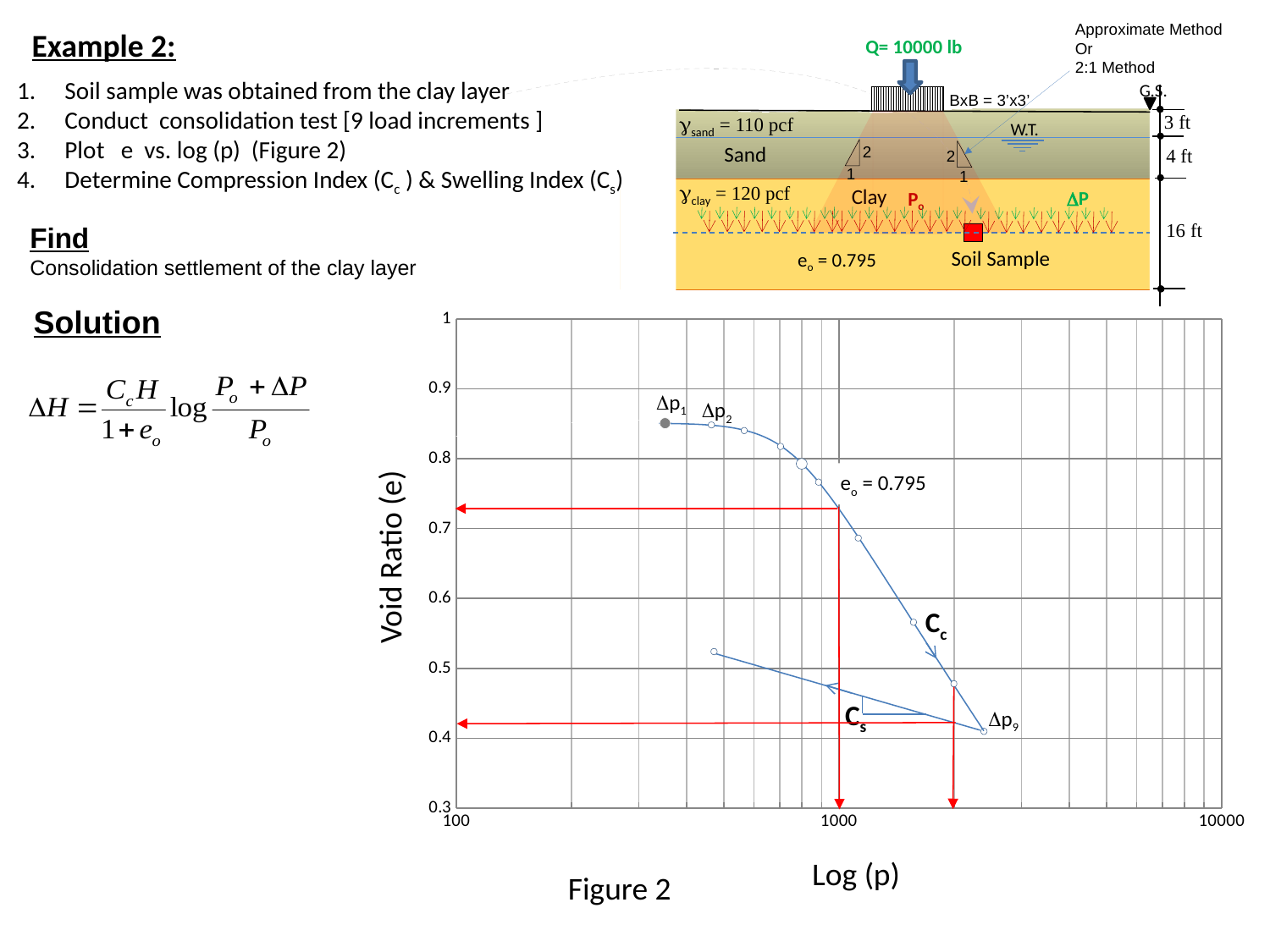
What is the label of the y-axis in Figure 2? Void Ratio (e) In Figure 2, what value of e_o is annotated on the chart? 0.795 What kind of chart is Figure 2? line chart What is the highest tick value shown on the y-axis of Figure 2? 1 What is the lowest tick value shown on the x-axis of Figure 2? 100 What is the label of the x-axis in Figure 2? Log (p) In Figure 2, is the void ratio at point Δp1 greater or less than 0.8? greater In Figure 2, is the void ratio at point Δp9 greater or less than 0.5? less In Figure 2, which point has the higher void ratio, Δp1 or Δp9? Δp1 In Figure 2, is the pressure at point Δp9 greater or less than 1000? greater In Figure 2, does the void ratio rise or fall as the pressure p increases along the loading curve from Δp1 to Δp9? fall